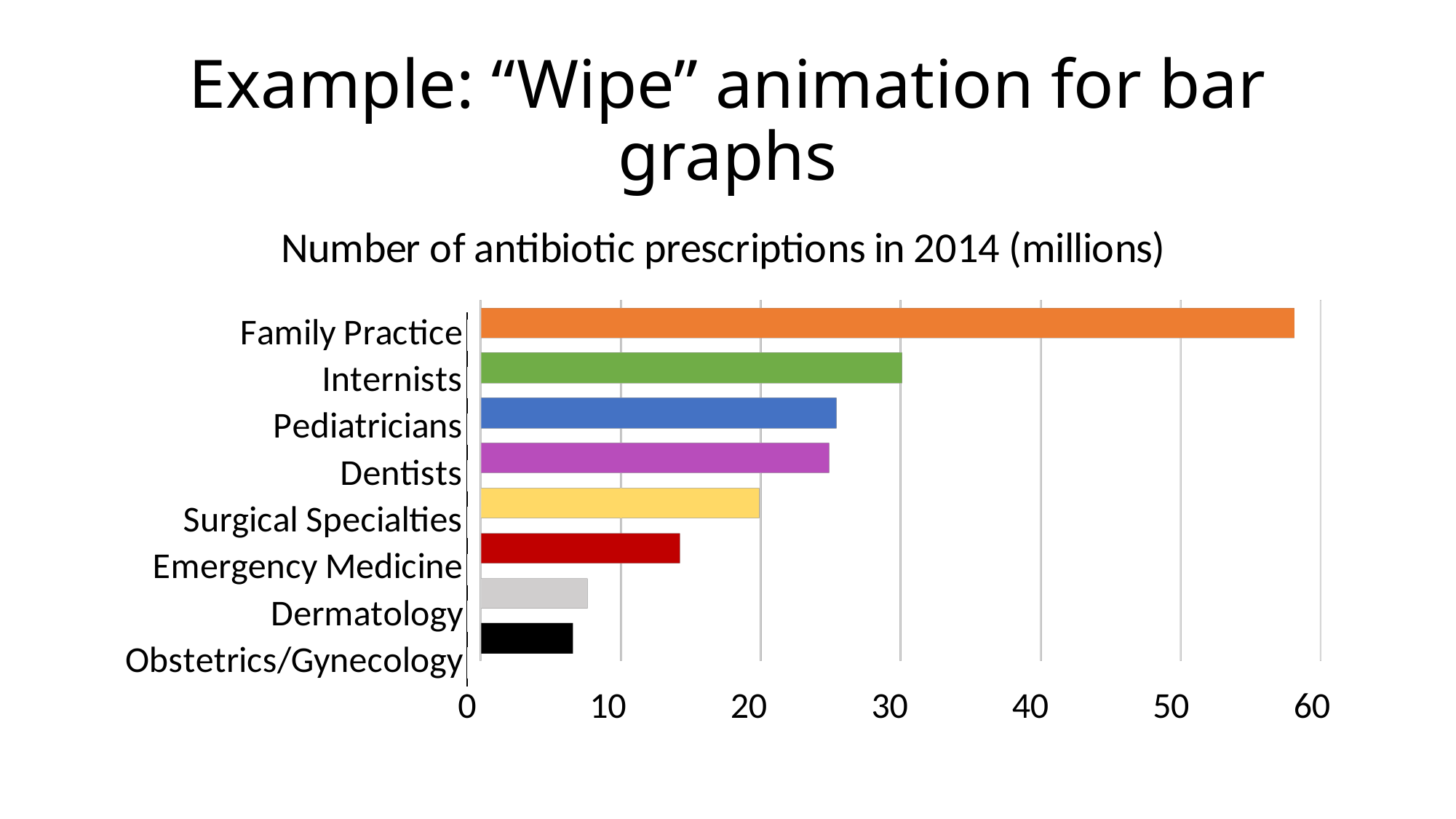
Is the value for Family Practice greater or less than 50? greater Is the value for Dentists greater or less than 20? greater Which has more antibiotic prescriptions, Surgical Specialties or Emergency Medicine? Surgical Specialties Which has more antibiotic prescriptions, Internists or Pediatricians? Internists What kind of chart is shown on the slide? bar chart What is the title of the chart? Number of antibiotic prescriptions in 2014 (millions) How many categories are plotted in the chart? 8 Is the value for Pediatricians greater or less than 30? less Which category has the highest number of antibiotic prescriptions? Family Practice Which category has the lowest number of antibiotic prescriptions? Obstetrics/Gynecology